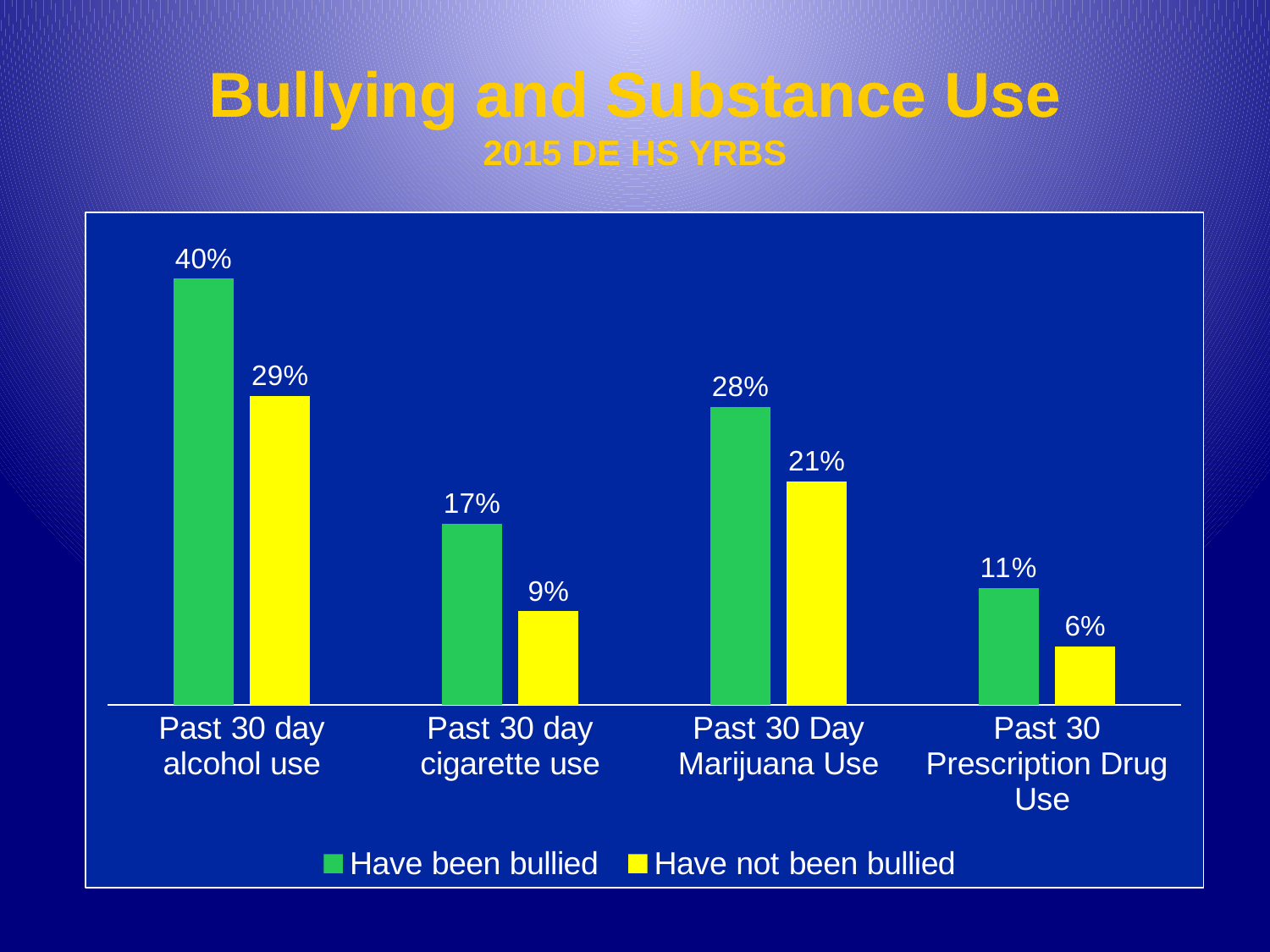
What is the value for 'Have not been bullied' in the Past 30 Prescription Drug Use category? 6% What kind of chart is shown on the slide? Bar chart What percentage of students who have been bullied reported past 30 day alcohol use? 40% What is the difference between the 'Have been bullied' and 'Have not been bullied' values for Past 30 day cigarette use? 8% What is the value for 'Have been bullied' in the Past 30 Day Marijuana Use category? 28% Which is larger: the 'Have not been bullied' value for Past 30 day alcohol use or the 'Have been bullied' value for Past 30 Day Marijuana Use? Have not been bullied value for Past 30 day alcohol use Which category has the lowest value for students who have not been bullied? Past 30 Prescription Drug Use What is the value for 'Have not been bullied' in the Past 30 day cigarette use category? 9% What is the difference between the 'Have been bullied' and 'Have not been bullied' values for Past 30 day alcohol use? 11% How many series does the legend list? 2 Which category has the highest value for students who have been bullied? Past 30 day alcohol use How many substance use categories are shown on the x axis? 4